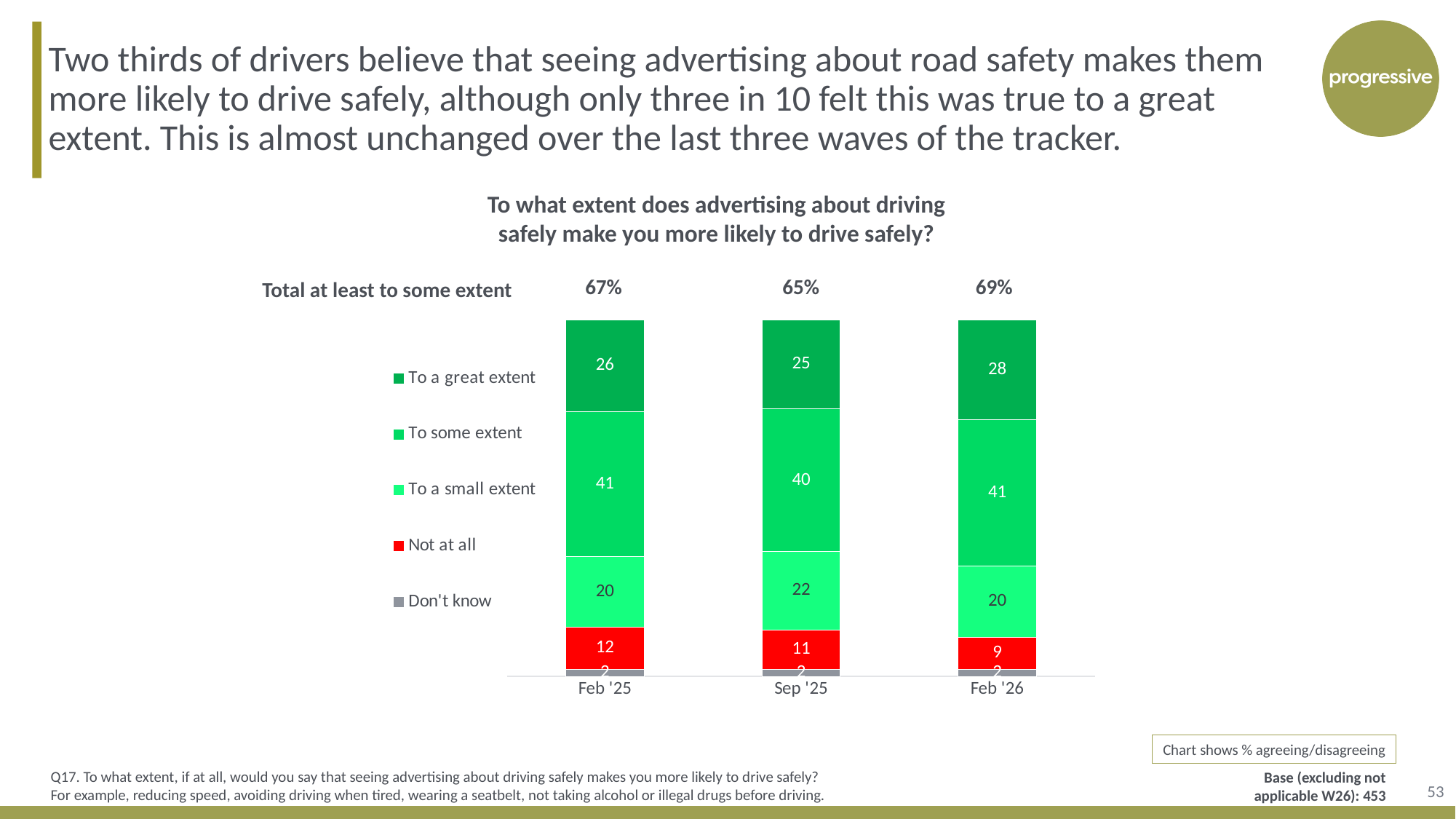
Which colour represents 'Not at all' in the legend? Red What is the difference between the 'To a small extent' values for Sep '25 and Feb '26? 2 Is the 'To some extent' value larger in Feb '25 or Sep '25? Feb '25 Which wave has the lowest value for 'Not at all'? Feb '26 How many series does the legend list? 5 What is the value for 'Not at all' in Sep '25? 11 How many waves (categories) are shown on the x axis? 3 What is the value for 'To a great extent' in Feb '26? 28 What kind of chart is shown? Stacked bar chart What is the total of the 'To a great extent' and 'To some extent' segments for Sep '25? 65 What is the 'Total at least to some extent' figure shown for Feb '25? 67% Which wave has the highest 'Total at least to some extent' figure? Feb '26